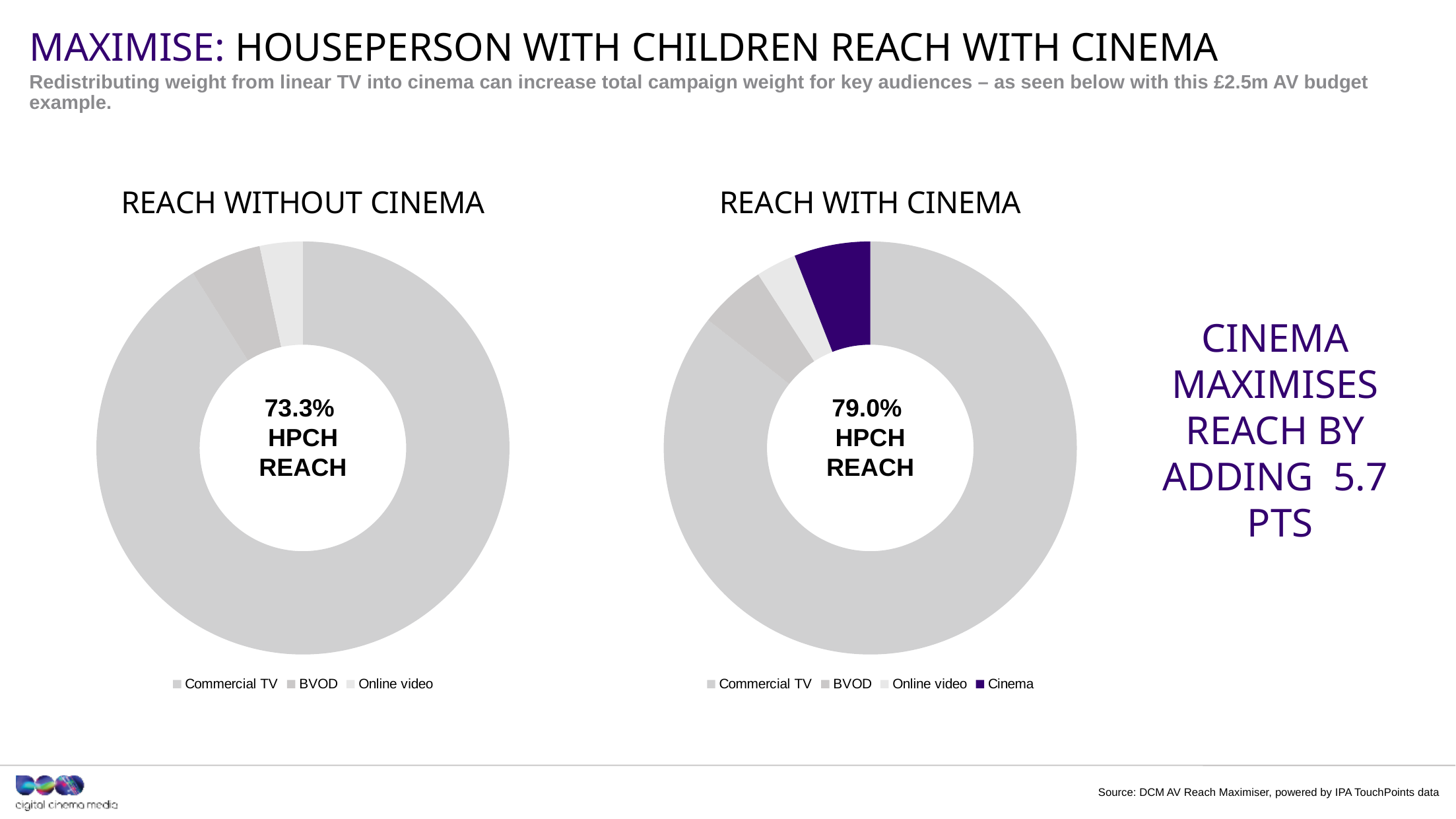
In the 'Reach without cinema' chart, which category has the smallest slice? Online video How many categories does the legend of the 'Reach without cinema' chart list? 3 In the 'Reach with cinema' chart, what HPCH reach value is shown in the centre? 79.0% In the 'Reach without cinema' chart, what HPCH reach value is shown in the centre? 73.3% In the 'Reach without cinema' chart, which category has the largest slice? Commercial TV How many categories does the legend of the 'Reach with cinema' chart list? 4 In the 'Reach with cinema' chart, what colour is the Cinema slice? purple Which chart shows the higher HPCH reach: 'Reach without cinema' or 'Reach with cinema'? Reach with cinema By how many percentage points does the HPCH reach in the 'Reach with cinema' chart exceed the HPCH reach in the 'Reach without cinema' chart? 5.7 In the 'Reach with cinema' chart, which category has the largest slice? Commercial TV What kind of chart is the 'Reach without cinema' chart? doughnut chart In the 'Reach with cinema' chart, which slice is larger: Commercial TV or Cinema? Commercial TV